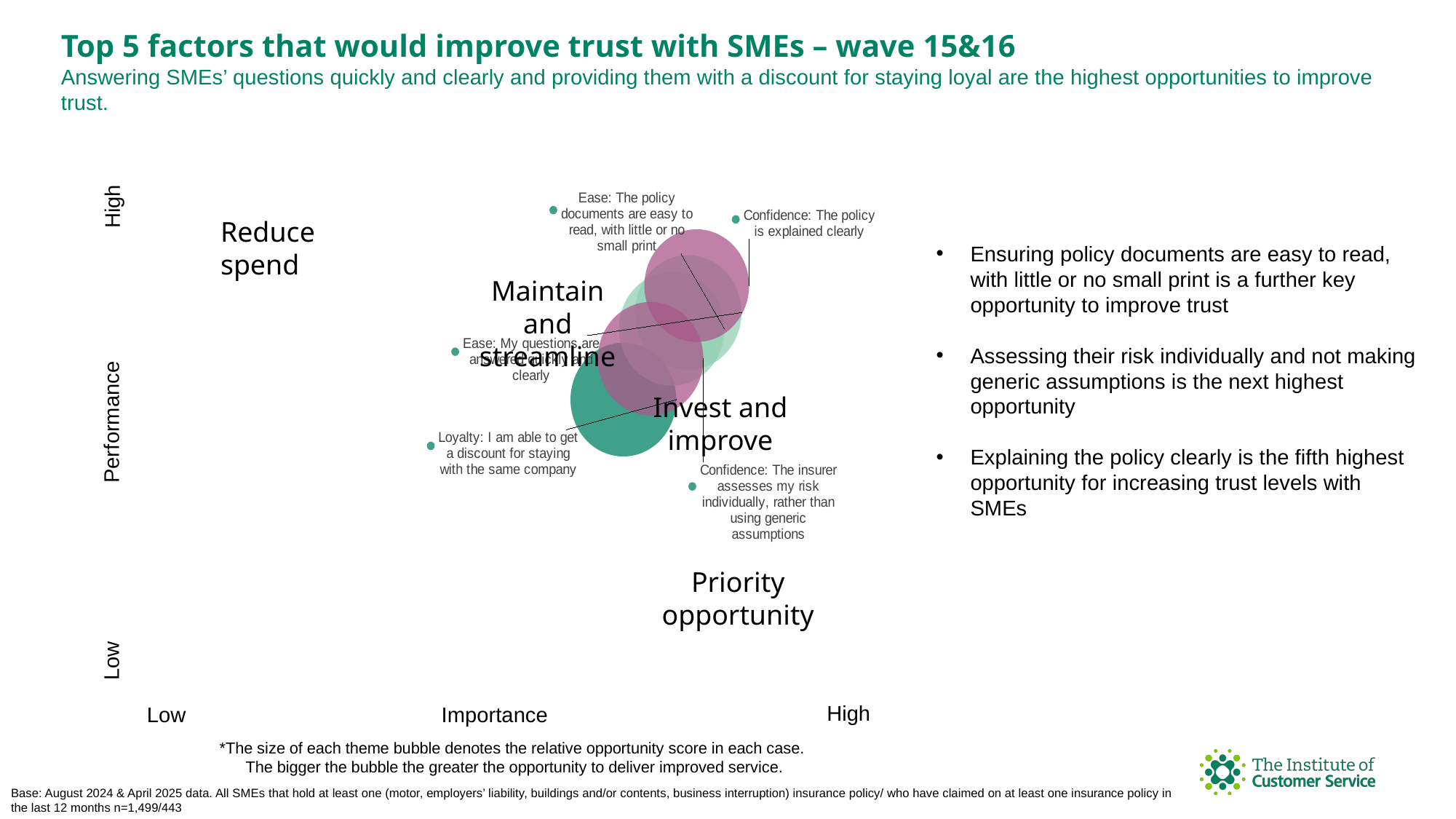
Which is plotted higher on the Performance axis: 'Loyalty: I am able to get a discount for staying with the same company' or 'Ease: My questions are answered quickly and clearly'? Ease: My questions are answered quickly and clearly Which factor is plotted lowest on the Performance axis? Loyalty: I am able to get a discount for staying with the same company What is the label of the vertical axis of the chart? Performance Which factor is plotted furthest to the right on the Importance axis? Confidence: The policy is explained clearly How many factors are plotted on the chart? 5 What kind of chart is shown on the slide? Bubble chart Which factor is plotted furthest to the left on the Importance axis? Loyalty: I am able to get a discount for staying with the same company What is the label of the horizontal axis of the chart? Importance Which is plotted higher on the Performance axis: 'Ease: The policy documents are easy to read, with little or no small print' or 'Loyalty: I am able to get a discount for staying with the same company'? Ease: The policy documents are easy to read, with little or no small print Which is plotted further right on the Importance axis: 'Loyalty: I am able to get a discount for staying with the same company' or 'Confidence: The insurer assesses my risk individually, rather than using generic assumptions'? Confidence: The insurer assesses my risk individually, rather than using generic assumptions